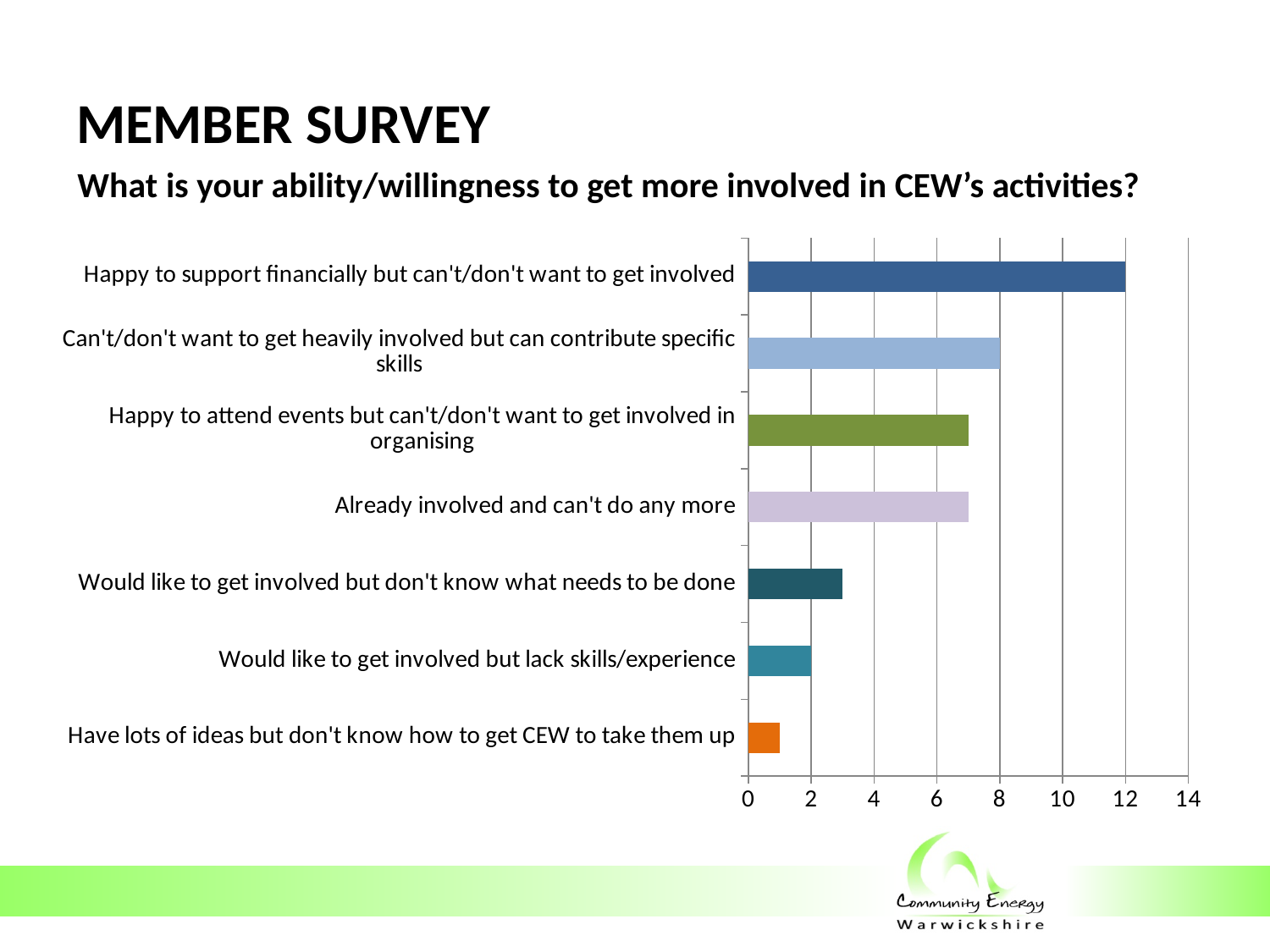
How many categories are plotted in the chart? 7 What is the value for 'Happy to support financially but can't/don't want to get involved'? 12 Which category has the lowest value? Have lots of ideas but don't know how to get CEW to take them up Which is larger: the value for 'Can't/don't want to get heavily involved but can contribute specific skills' or the value for 'Would like to get involved but don't know what needs to be done'? Can't/don't want to get heavily involved but can contribute specific skills Which category has the highest value? Happy to support financially but can't/don't want to get involved What is the difference between the values for 'Happy to support financially but can't/don't want to get involved' and 'Can't/don't want to get heavily involved but can contribute specific skills'? 4 What kind of chart is shown on the slide? bar chart What question does the chart's heading say the survey asked? What is your ability/willingness to get more involved in CEW's activities? Is the value for 'Happy to attend events but can't/don't want to get involved in organising' greater or less than 6? greater Is the value for 'Would like to get involved but don't know what needs to be done' greater or less than 4? less What is the value for 'Can't/don't want to get heavily involved but can contribute specific skills'? 8 What is the value for 'Would like to get involved but lack skills/experience'? 2